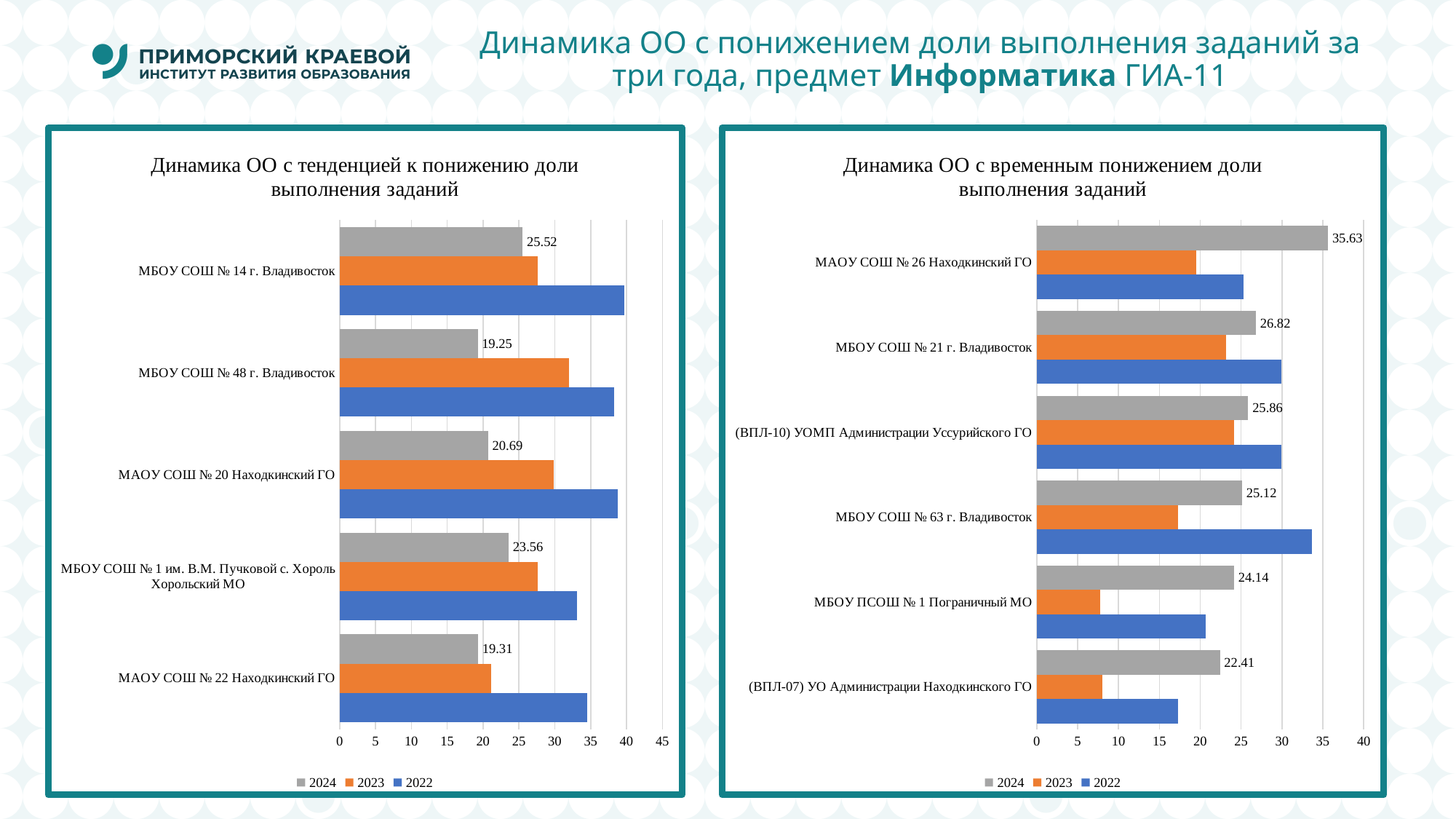
In the left chart (Динамика ОО с тенденцией к понижению доли выполнения заданий), what is the 2024 value for МБОУ СОШ № 14 г. Владивосток? 25.52 How many series does the legend of the right chart list? 3 In the left chart, what is the difference between the 2024 values for МБОУ СОШ № 14 г. Владивосток and МАОУ СОШ № 22 Находкинский ГО? 6.21 In the right chart, is the 2023 value for МБОУ ПСОШ № 1 Пограничный МО greater or less than 10? less In the left chart, which school has the lowest 2024 value? МБОУ СОШ № 48 г. Владивосток In the left chart, is the 2022 value for МБОУ СОШ № 14 г. Владивосток greater or less than 35? greater In the left chart, which school has the highest 2024 value? МБОУ СОШ № 14 г. Владивосток In the right chart (Динамика ОО с временным понижением доли выполнения заданий), what is the 2024 value for МАОУ СОШ № 26 Находкинский ГО? 35.63 What type of chart is the right chart? bar chart In the right chart, which organisation has the lowest 2024 value? (ВПЛ-07) УО Администрации Находкинского ГО In the left chart, what is the 2024 value for МАОУ СОШ № 20 Находкинский ГО? 20.69 How many schools are shown in the left chart? 5